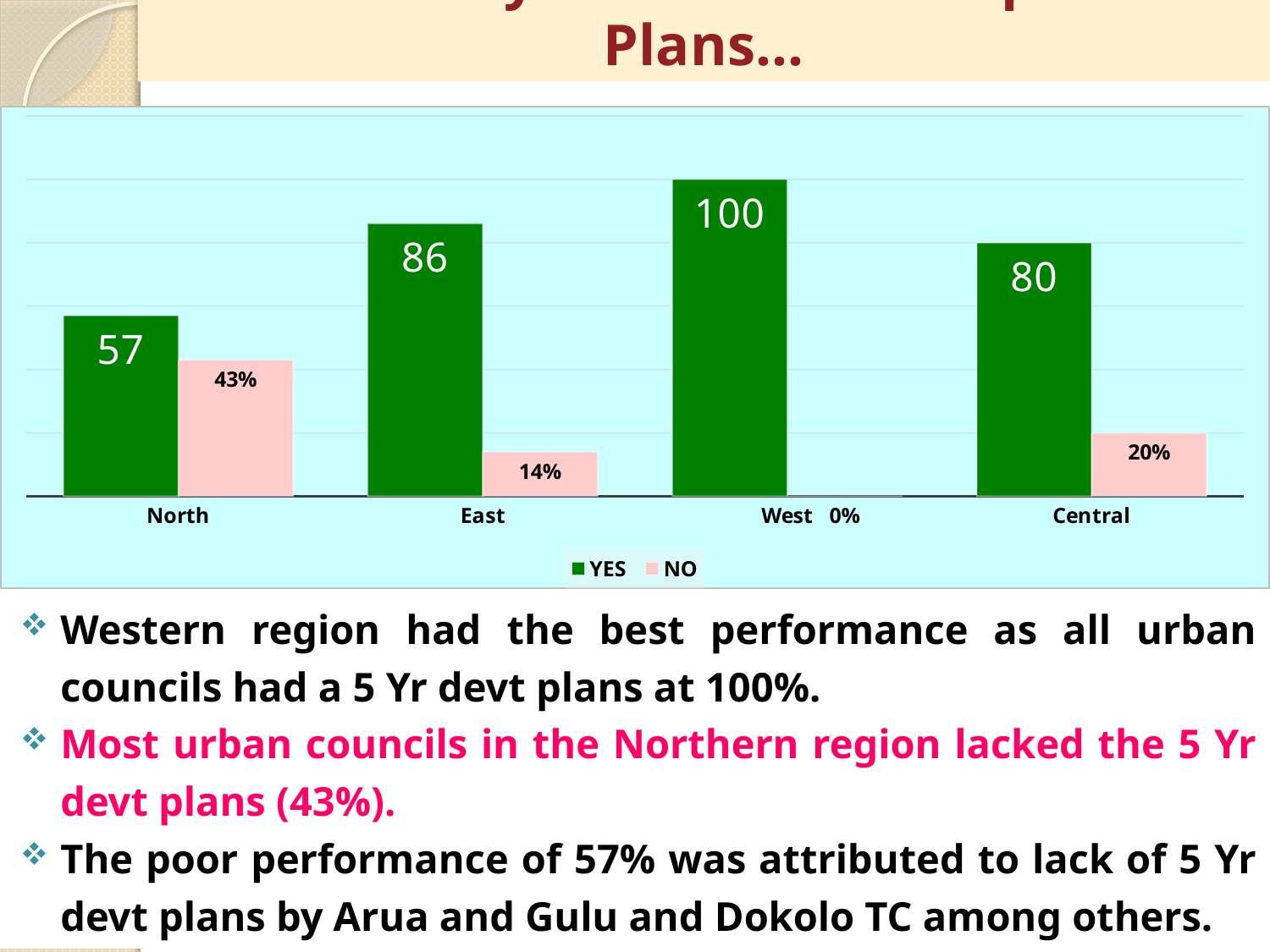
What kind of chart is shown on the slide? Bar chart What is the YES value for East? 86 How many regions are shown on the x axis? 4 How many series does the legend list? 2 What is the NO value for Central? 20% Which is larger, the YES value for East or the YES value for Central? East What is the difference between the YES values for West and Central? 20 Which region has the highest NO value? North What is the YES value for North? 57 Which region has the lowest YES value? North Which region has the highest YES value? West What is the NO value for West? 0%